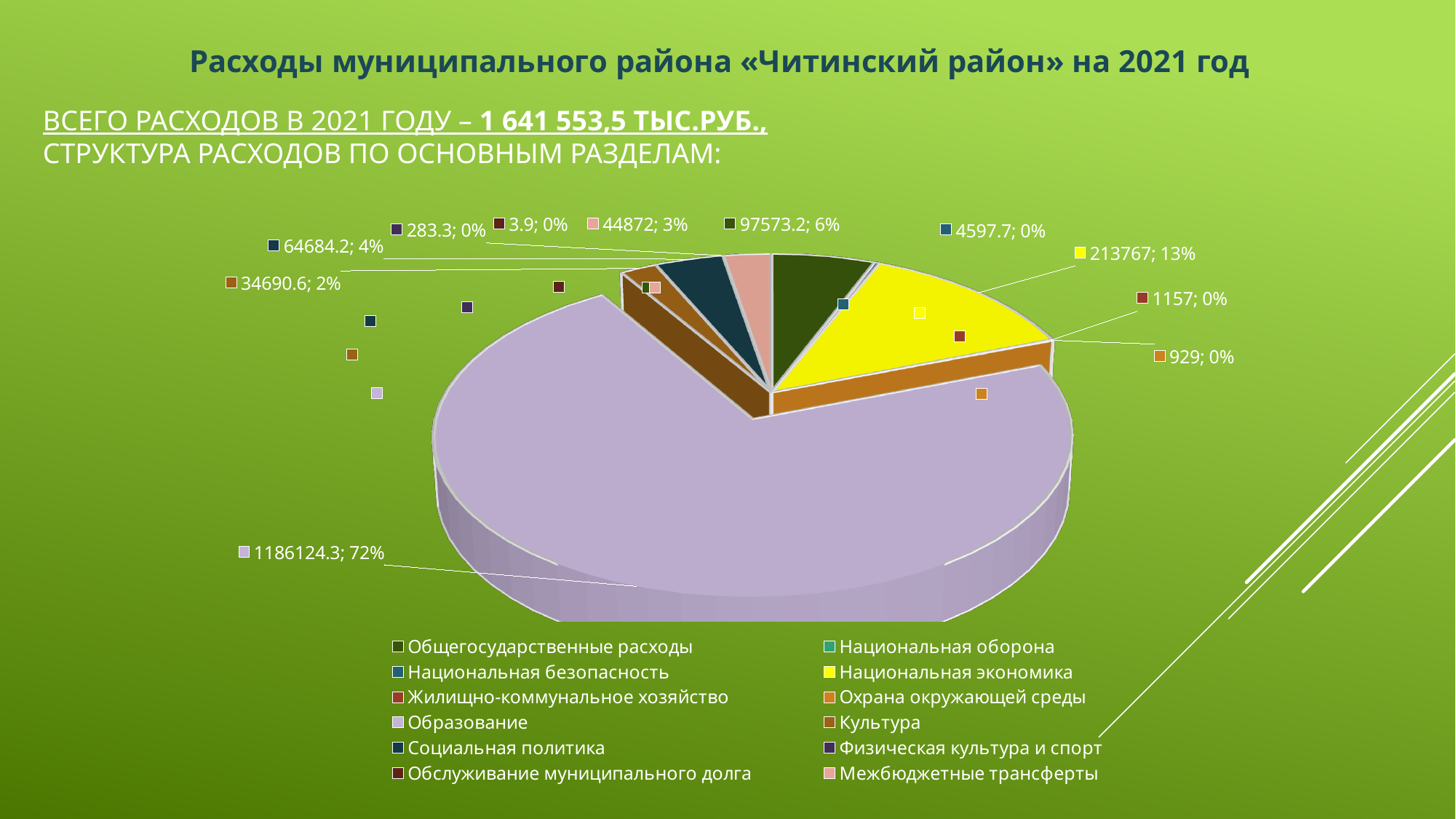
How many categories does the legend of the pie chart list? 12 What is the difference between the values for Жилищно-коммунальное хозяйство (1157) and Охрана окружающей среды (929)? 228 Which is larger: Национальная экономика or Общегосударственные расходы? Национальная экономика Which category has the largest slice of the pie? Образование What share of the pie does Образование account for? 72% What value is shown for Образование in the pie chart? 1186124.3 What type of chart is shown on the slide? Pie chart What value is shown for Национальная экономика? 213767 What value is shown for Межбюджетные трансферты? 44872 What share of the pie does Общегосударственные расходы account for? 6% What value is shown for Культура? 34690.6